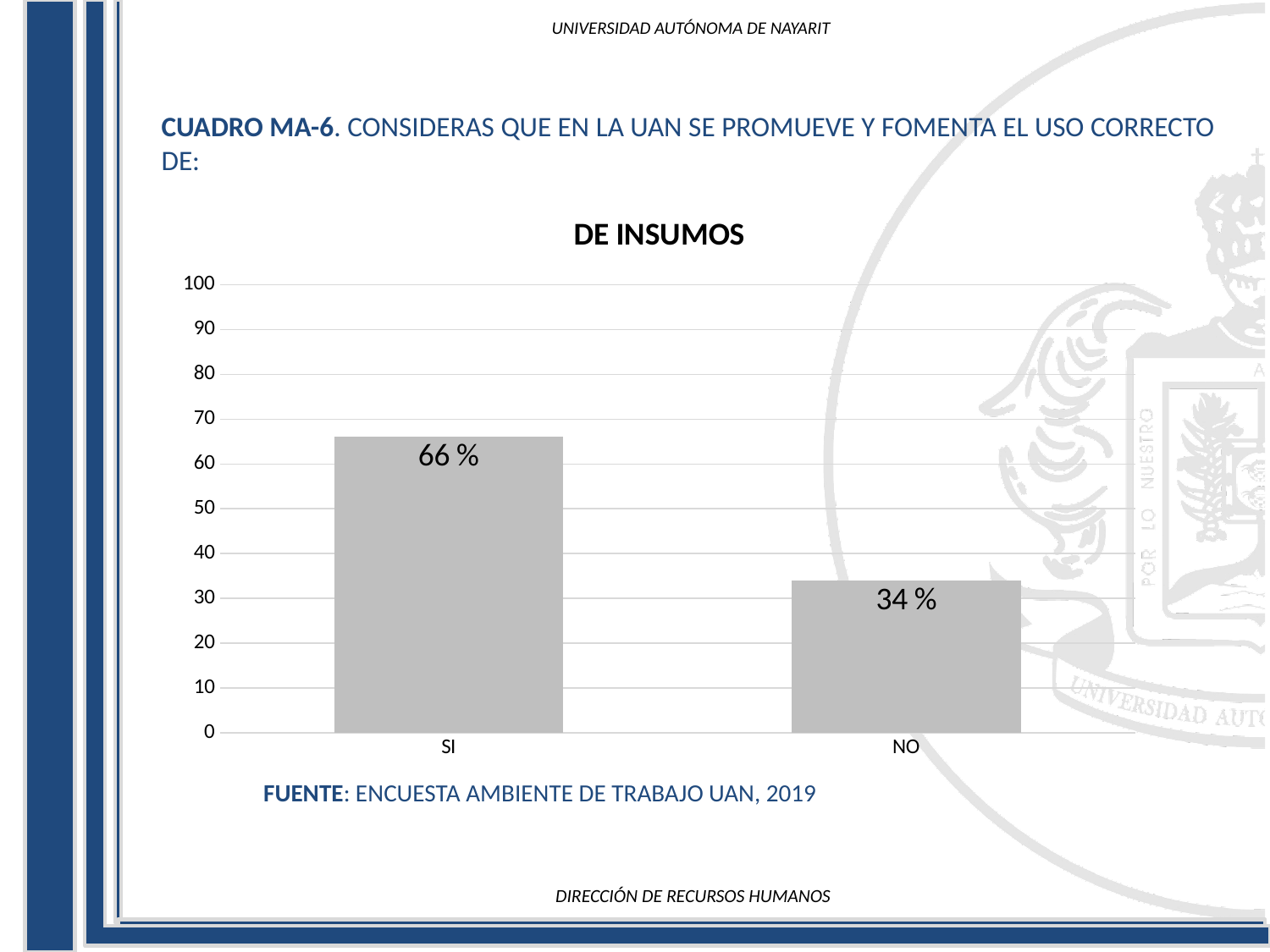
What kind of chart is shown? bar chart How many categories are shown on the x axis? 2 What is the title of the chart? DE INSUMOS What is the value for SI? 66 % Is the value for NO greater or less than 40? less What is the difference between the values for SI and NO? 32 % What is the value for NO? 34 % Which is larger, the value for SI or the value for NO? SI Which category has the highest value? SI What is the highest value shown on the y axis? 100 Which category has the lowest value? NO Is the value for SI greater or less than 60? greater